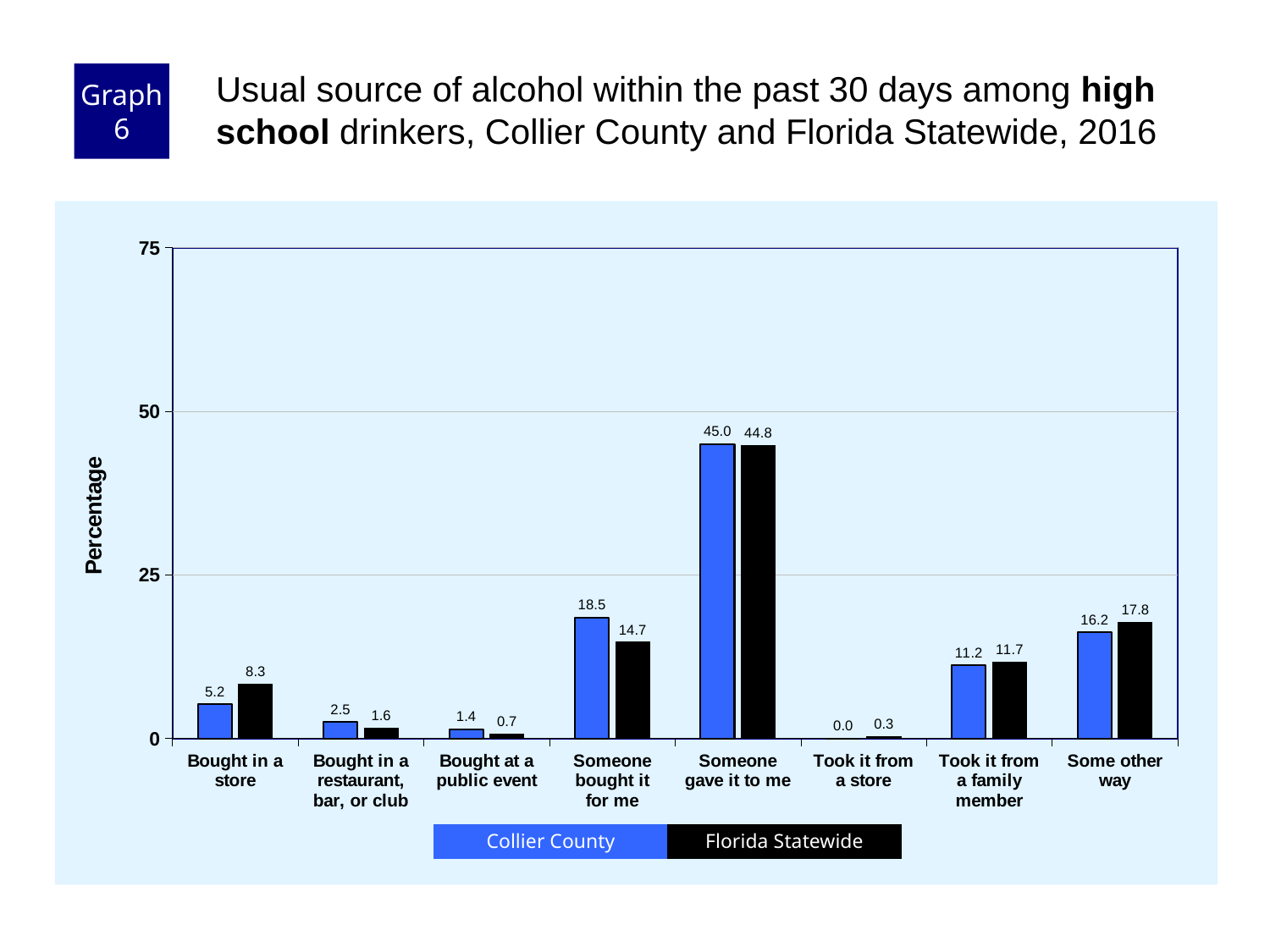
Which is larger for "Some other way": Collier County or Florida Statewide? Florida Statewide What is the label of the y axis? Percentage What is the Collier County value for "Someone gave it to me"? 45.0 Is the Collier County value for "Someone gave it to me" greater or less than 25? greater What kind of chart is shown on the slide? Bar chart What is the Collier County value for "Took it from a family member"? 11.2 How many categories are shown on the x axis? 8 How many series does the legend list? 2 Which category has the highest Florida Statewide value? Someone gave it to me What is the Florida Statewide value for "Bought in a store"? 8.3 Which category has the lowest Collier County value? Took it from a store What is the difference between the Collier County and Florida Statewide values for "Someone bought it for me"? 3.8